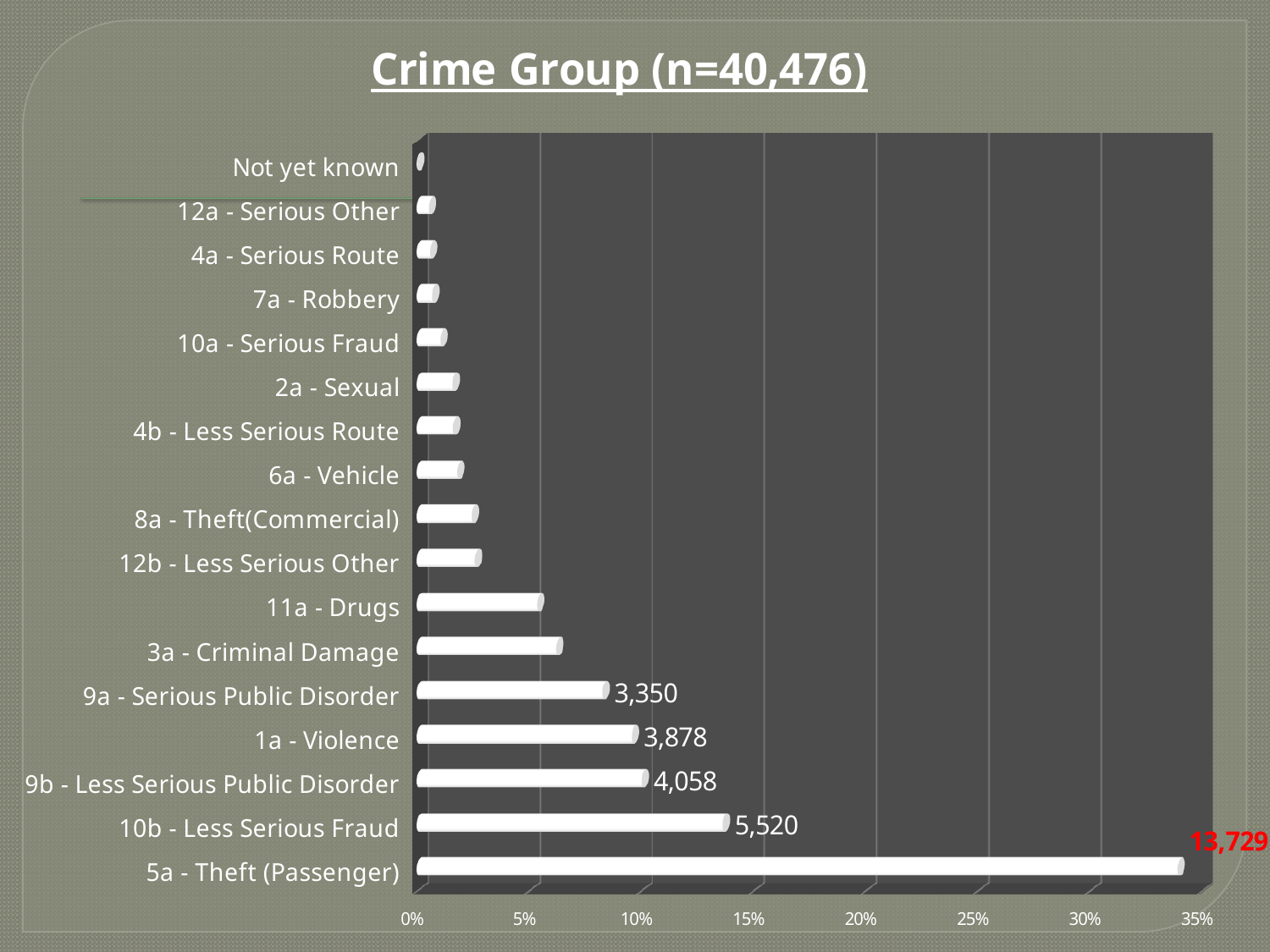
How many crime group categories are shown on the chart? 17 What is the value shown for 5a - Theft (Passenger)? 13,729 Which crime group has the lowest value? Not yet known What kind of chart is shown on the slide? bar chart What is the difference between the values for 1a - Violence and 9a - Serious Public Disorder? 528 Is the value for 3a - Criminal Damage greater or less than 5%? greater What is the value shown for 9b - Less Serious Public Disorder? 4,058 What is the difference between the values for 10b - Less Serious Fraud and 9b - Less Serious Public Disorder? 1,462 What is the value shown for 10b - Less Serious Fraud? 5,520 Which crime group has the highest value? 5a - Theft (Passenger) Which is larger, the value for 3a - Criminal Damage or the value for 11a - Drugs? 3a - Criminal Damage What is the value shown for 1a - Violence? 3,878